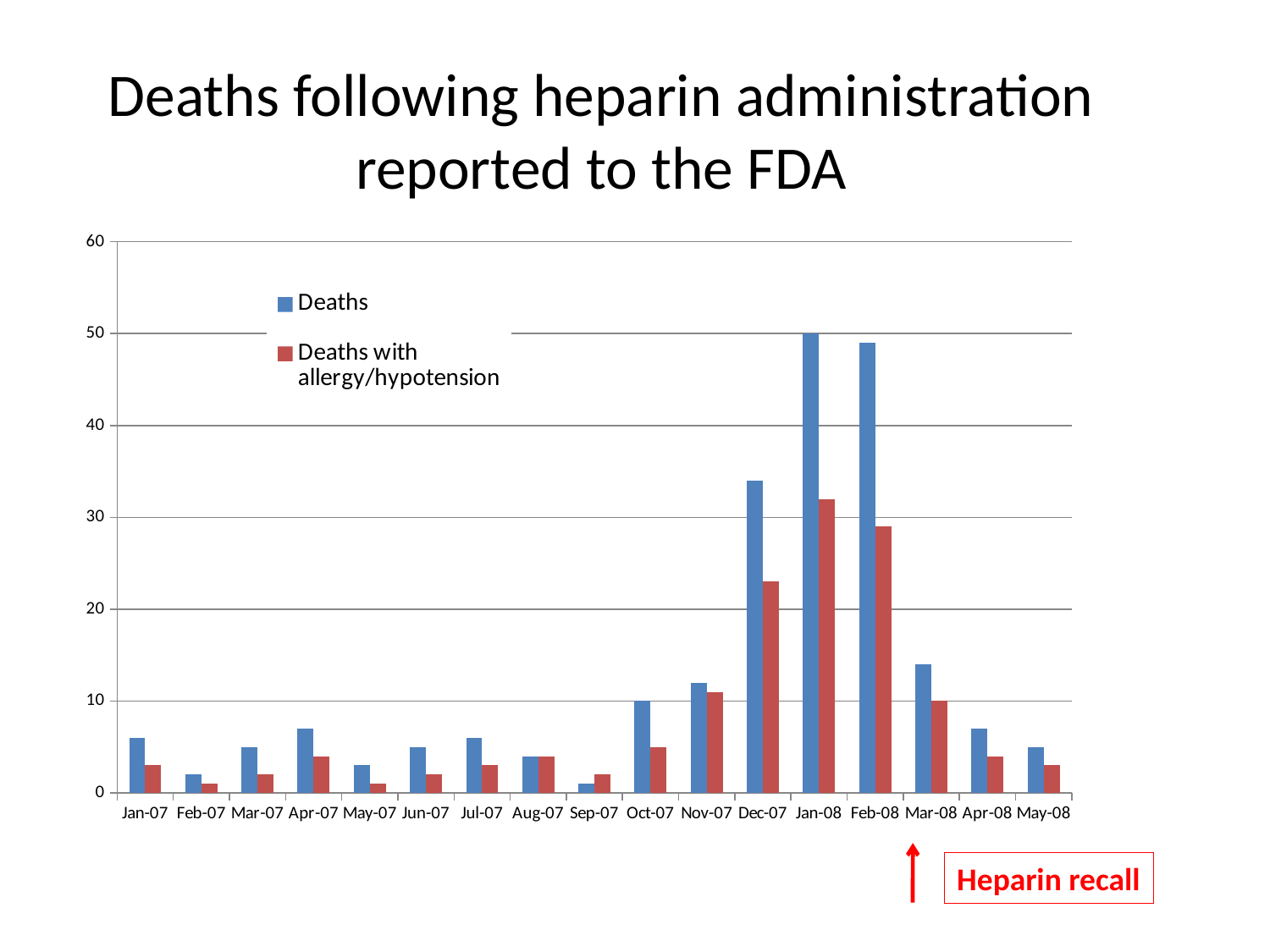
How many series does the legend list? 2 What type of chart is shown on the slide? Bar chart Is the value for Deaths in Feb-08 greater or less than 40? greater Is the value for Deaths in Dec-07 greater or less than 30? greater Which month has the highest value for Deaths with allergy/hypotension? Jan-08 Is the value for Deaths in Apr-07 greater or less than 10? less How many months are shown on the x axis? 17 Which month does the 'Heparin recall' arrow point to? Mar-08 Which month has the lowest value for Deaths? Sep-07 Which is larger, Deaths in Dec-07 or Deaths in Feb-08? Feb-08 Which month has the highest value for Deaths? Jan-08